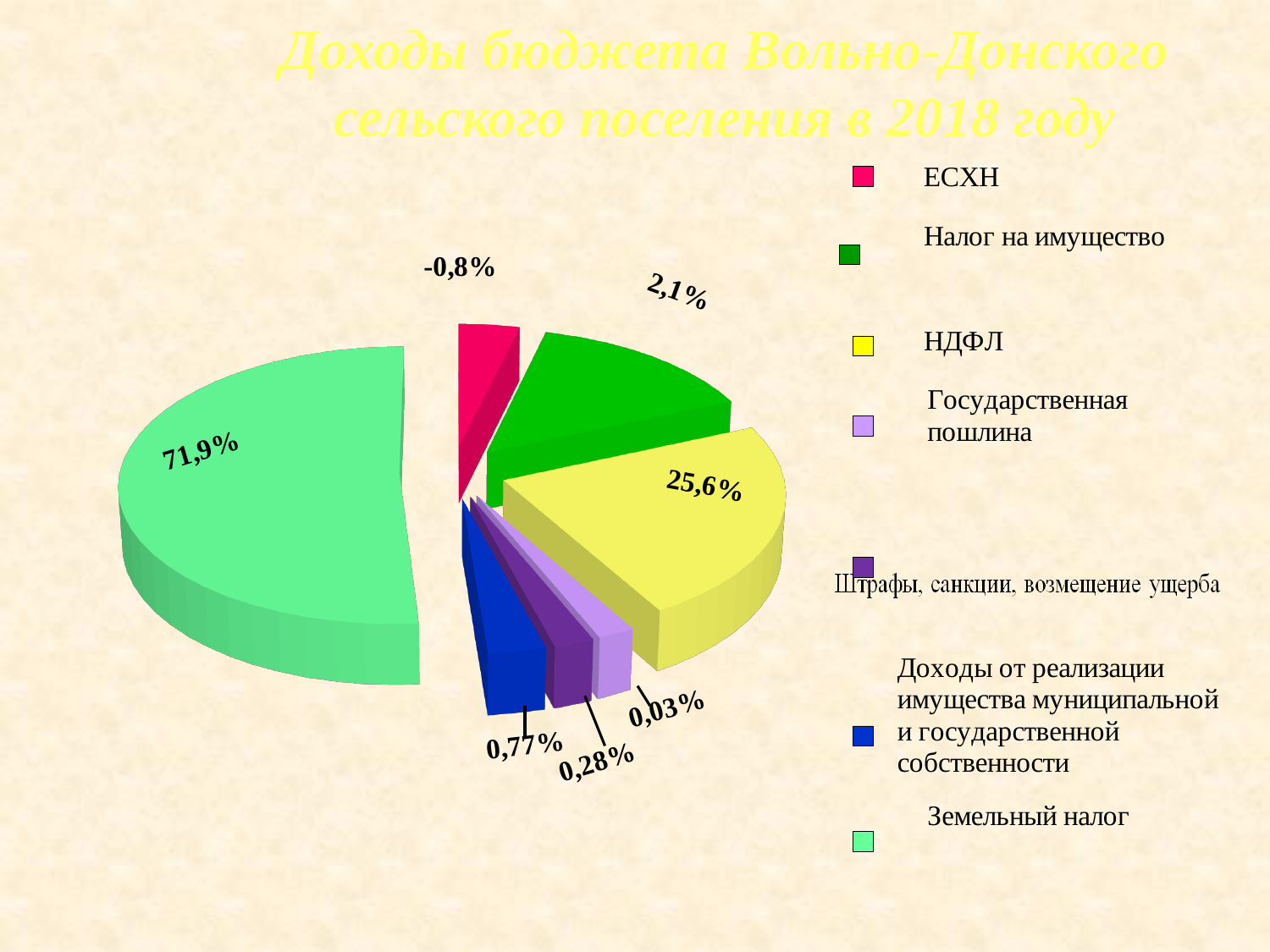
What share of the pie is labelled for Земельный налог? 71,9% Which category has the largest slice of the pie? Земельный налог What value is labelled for Государственная пошлина? 0,03% What value is labelled for Штрафы, санкции, возмещение ущерба? 0,28% What kind of chart is shown on the slide? Pie chart What share of the pie is labelled for Налог на имущество? 2,1% Which is larger, the share of НДФЛ or the share of Налог на имущество? НДФЛ What share of the pie is labelled for НДФЛ? 25,6% What is the difference between the shares of Земельный налог and НДФЛ? 46,3% What is the title of the chart? Доходы бюджета Вольно-Донского сельского поселения в 2018 году What value is labelled for Доходы от реализации имущества муниципальной и государственной собственности? 0,77% How many entries does the legend list? 7